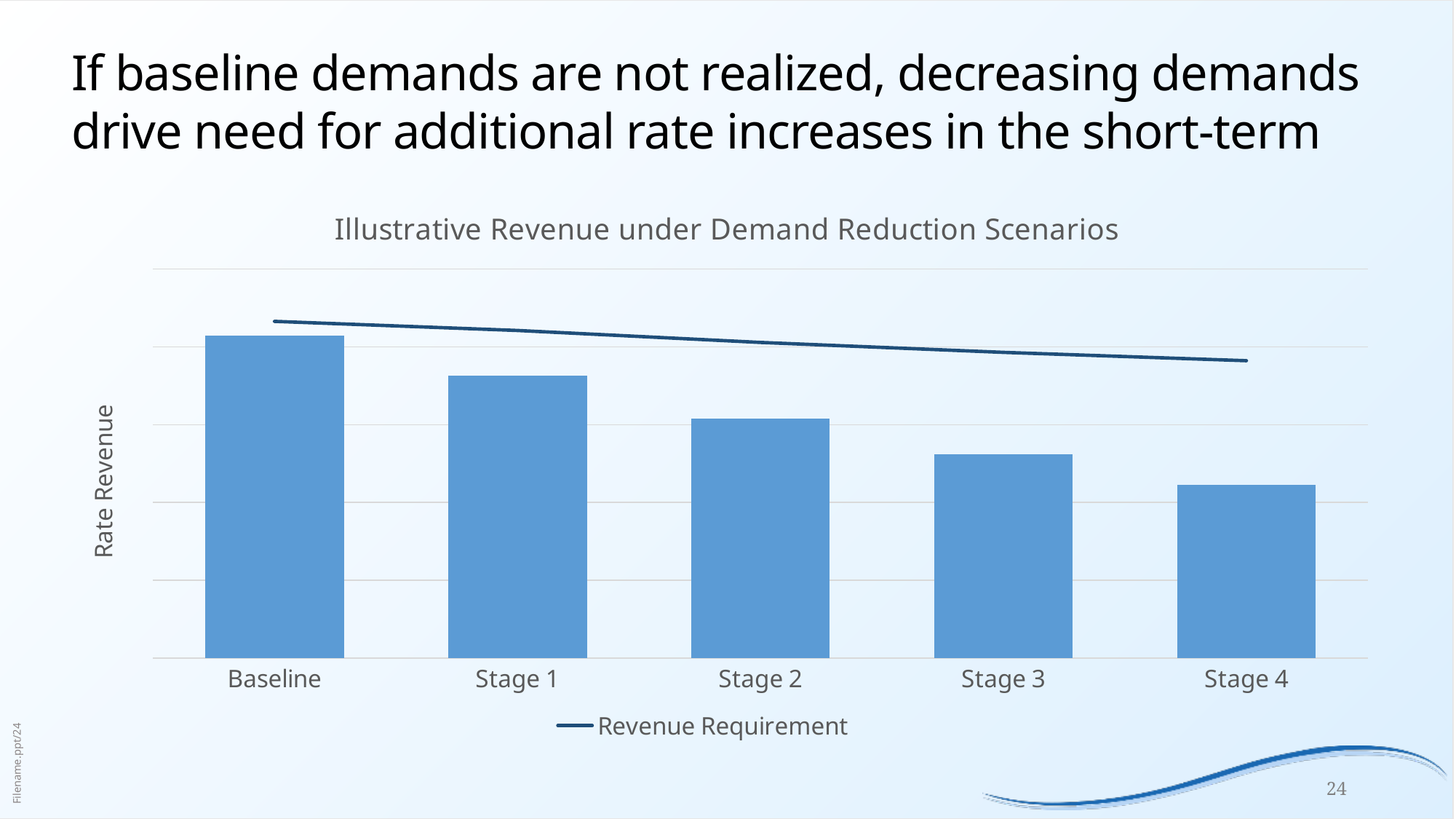
What is the label on the y axis of the chart? Rate Revenue Which bar is taller, Stage 1 or Stage 3? Stage 1 What is the title of the chart? Illustrative Revenue under Demand Reduction Scenarios Do the bar values rise or fall from Baseline to Stage 4? fall Which category has the lowest bar in the chart? Stage 4 Which is higher at Stage 4, the bar or the Revenue Requirement line? Revenue Requirement line How many series does the chart's legend list? 1 Does the Revenue Requirement line rise or fall from Baseline to Stage 4? fall Which category has the highest bar in the chart? Baseline Which bar is taller, Stage 2 or Stage 4? Stage 2 How many categories are shown on the x axis of the chart? 5 What kind of chart is used to show rate revenue for the scenarios? bar chart